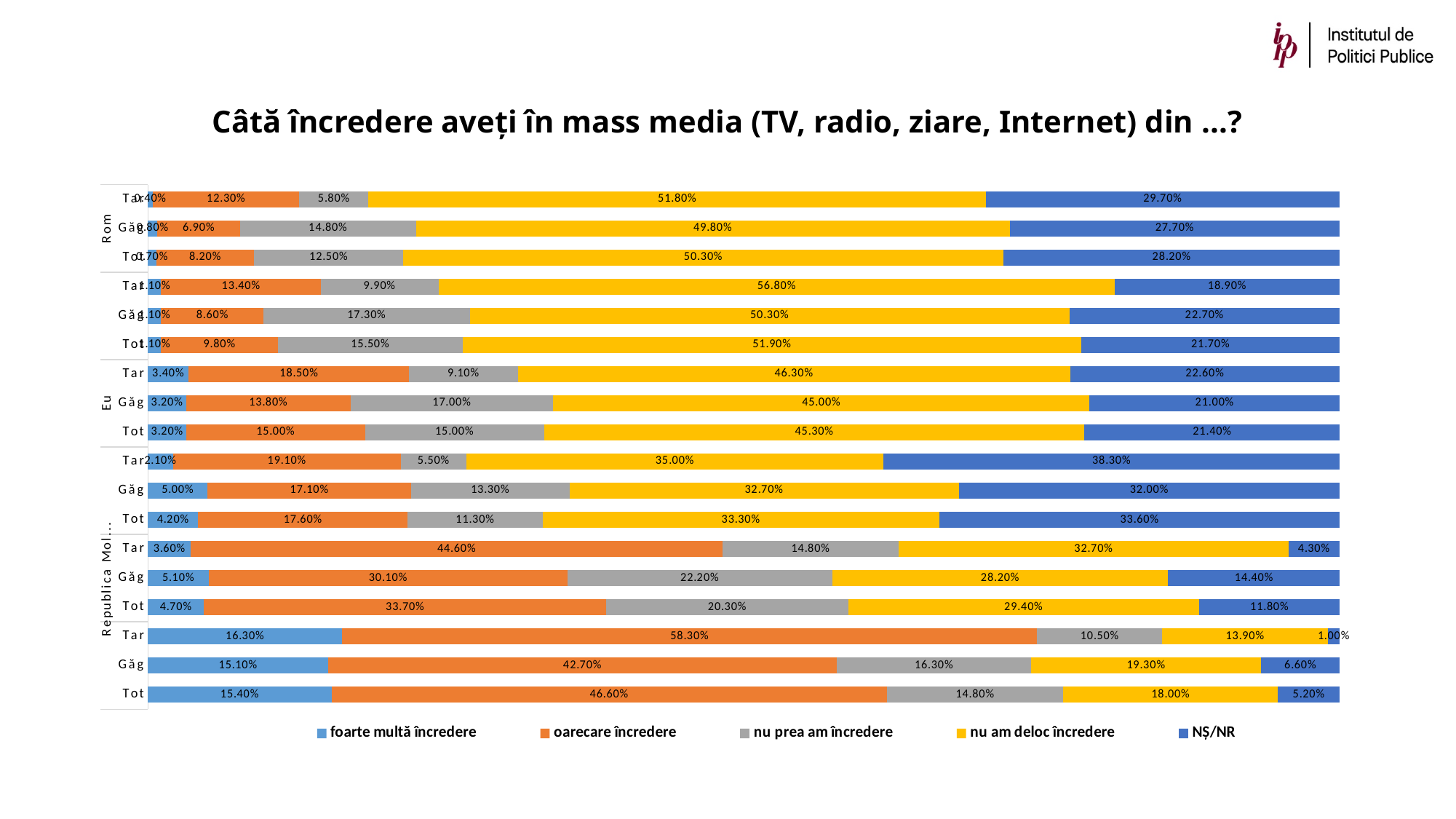
What colour represents 'NȘ/NR' in the legend? blue In the Rom group, which has the larger 'nu am deloc încredere' value, Tar or Găg? Tar In the Rom group, what is the 'nu am deloc încredere' value for Tot? 50.30% In the bottom bar (Tot), what is the difference between the 'oarecare încredere' value and the 'nu am deloc încredere' value? 28.60% In the Eu group, what is the NȘ/NR value for Tar? 22.60% In the bottom bar of the chart (Tot), what is the 'oarecare încredere' value? 46.60% How many series does the legend list? 5 In the third bar from the bottom (Tar), which series has the largest segment? oarecare încredere In the Eu group, what is the 'nu prea am încredere' value for Găg? 17.00% In the Rom group, what is the 'oarecare încredere' value for Găg? 6.90% How many bars are plotted in the chart? 18 What kind of chart is shown on the slide? stacked bar chart